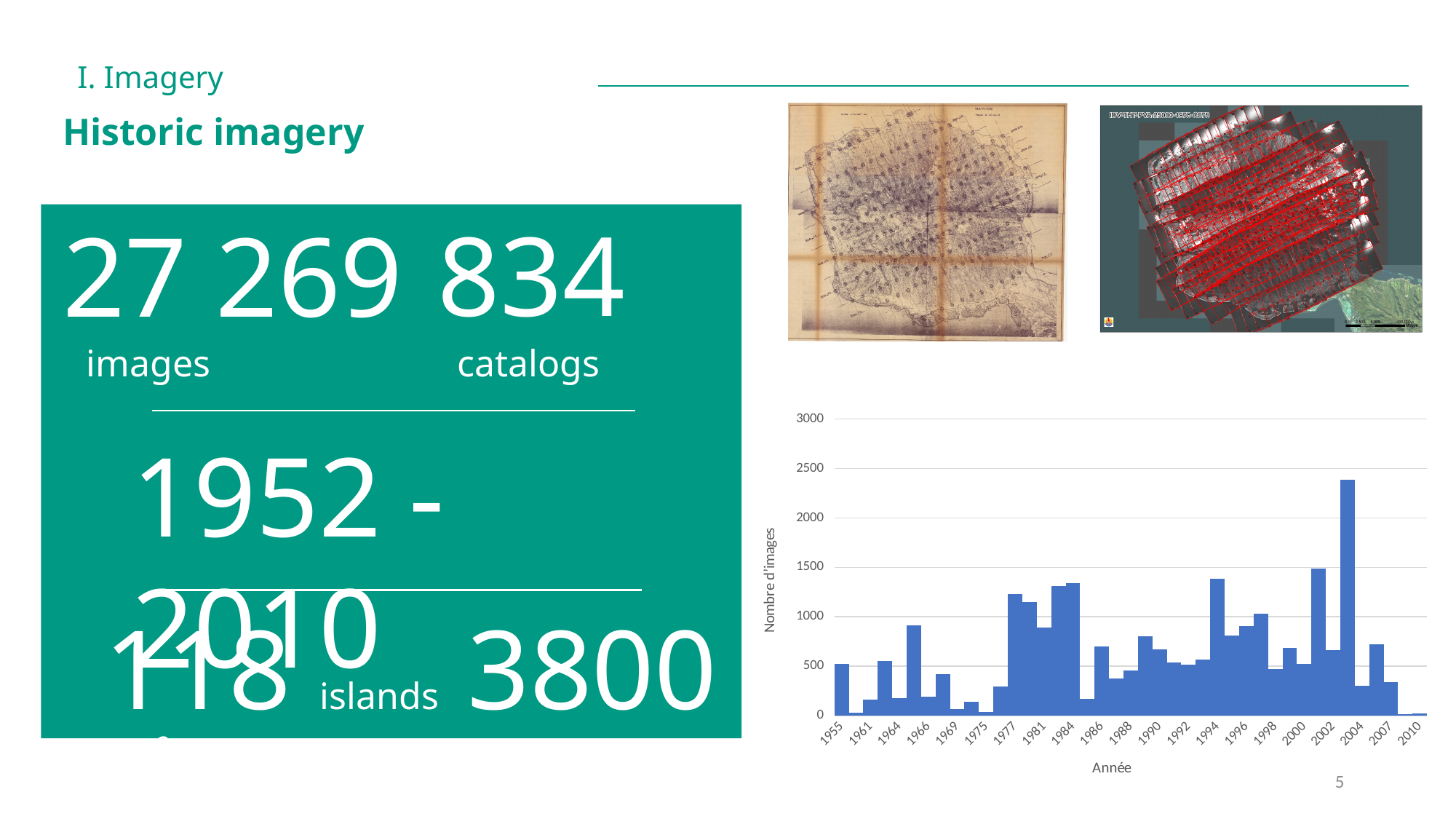
How many year labels are shown on the horizontal axis of the chart? 21 What is the title of the horizontal axis of the chart? Année Is the value for 2010 greater or less than 500? less Is the tallest bar in the chart greater or less than 2000? greater Is the value for 1975 greater or less than 500? less Which has the larger value, 1977 or 1961? 1977 What is the title of the vertical axis of the chart? Nombre d'images What kind of chart is shown on the slide? bar chart